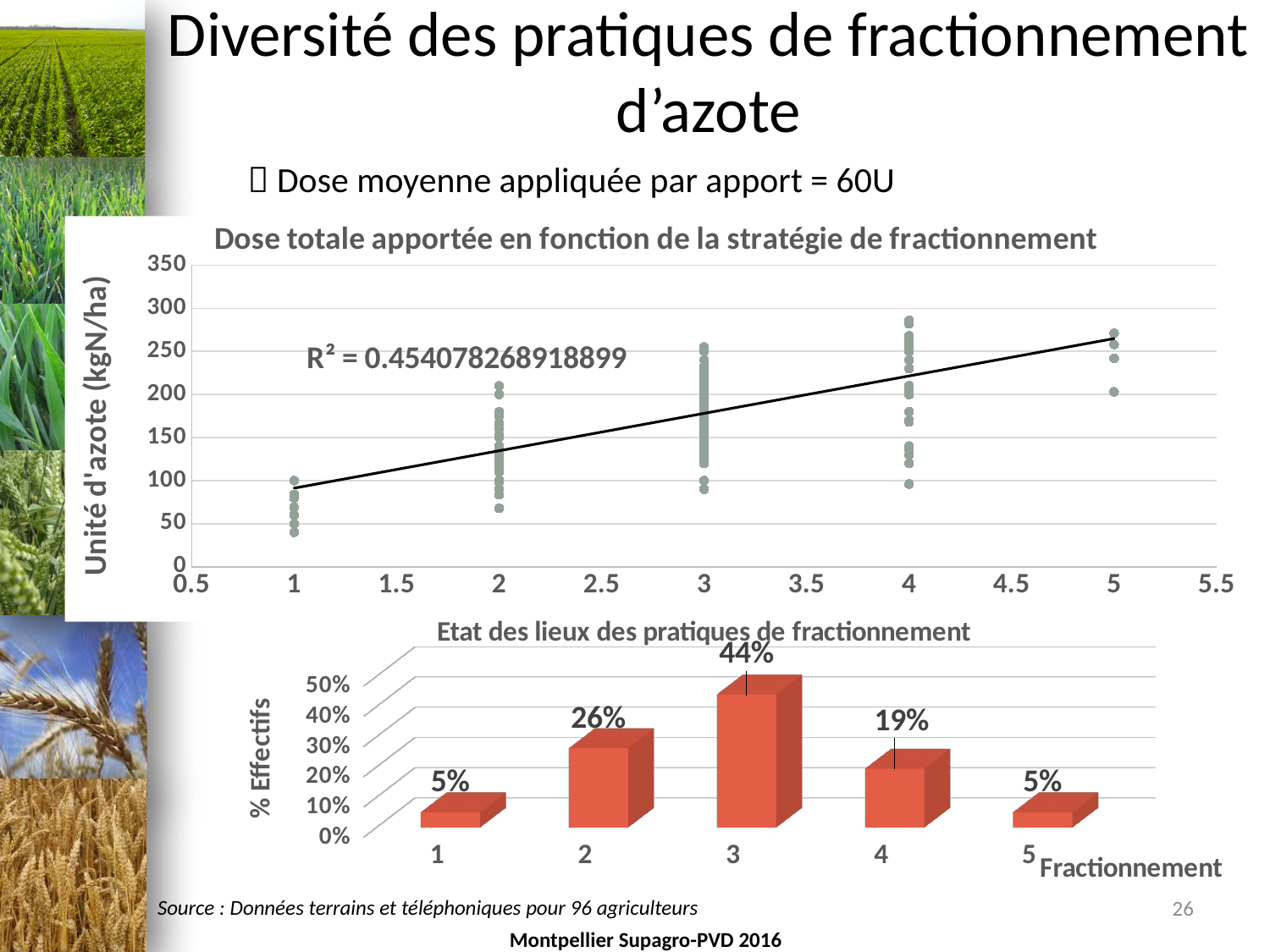
What is the y-axis label of the chart 'Dose totale apportée en fonction de la stratégie de fractionnement'? Unité d'azote (kgN/ha) In the chart 'Etat des lieux des pratiques de fractionnement', which is larger: the value for fractionnement 2 or fractionnement 4? Fractionnement 2 In the chart 'Etat des lieux des pratiques de fractionnement', what is the value for fractionnement 3? 44% In the chart 'Dose totale apportée en fonction de la stratégie de fractionnement', does the trendline rise or fall as the fractionnement increases? Rises What kind of chart is 'Dose totale apportée en fonction de la stratégie de fractionnement'? Scatter chart In the chart 'Etat des lieux des pratiques de fractionnement', what is the difference between the values for fractionnement 3 and fractionnement 2? 18% What kind of chart is 'Etat des lieux des pratiques de fractionnement'? Bar chart How many categories are shown on the x axis of the chart 'Etat des lieux des pratiques de fractionnement'? 5 In the chart 'Etat des lieux des pratiques de fractionnement', what is the value for fractionnement 4? 19% In the chart 'Etat des lieux des pratiques de fractionnement', what is the value for fractionnement 2? 26% In the chart 'Etat des lieux des pratiques de fractionnement', which fractionnement category has the highest percentage? 3 In the chart 'Dose totale apportée en fonction de la stratégie de fractionnement', what R² value is shown for the trendline? R² = 0.454078268918899